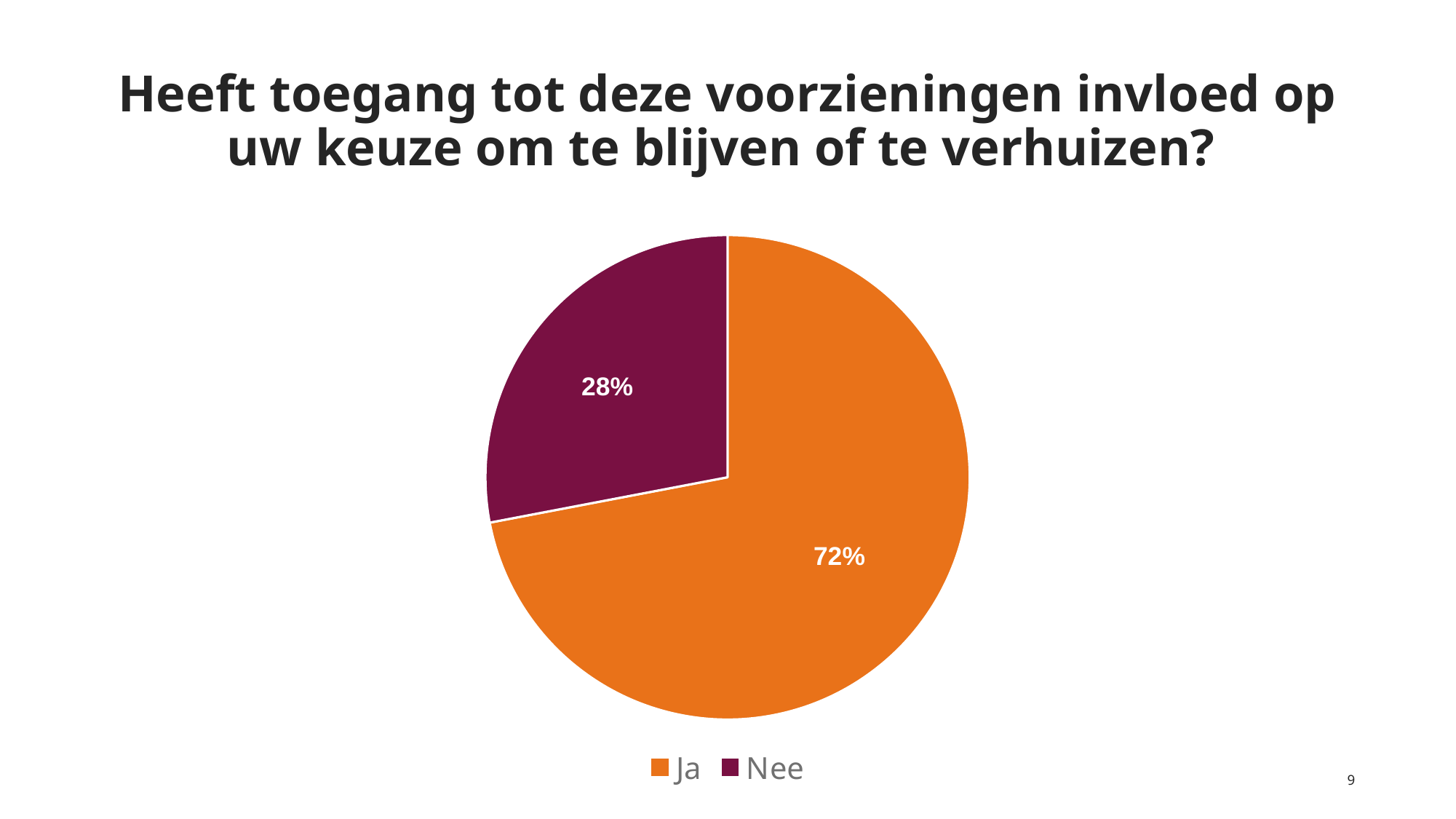
How many slices does the pie chart have? 2 What is the difference in percentage points between the "Ja" and "Nee" slices? 44 Which slice is the smallest? Nee What kind of chart is shown on the slide? pie chart How many entries does the legend list? 2 What colour is the "Nee" slice? purple What share of the pie does "Ja" represent? 72% What colour is the "Ja" slice? orange What share of the pie does "Nee" represent? 28% Which slice is the largest? Ja Which is larger, the "Ja" slice or the "Nee" slice? Ja